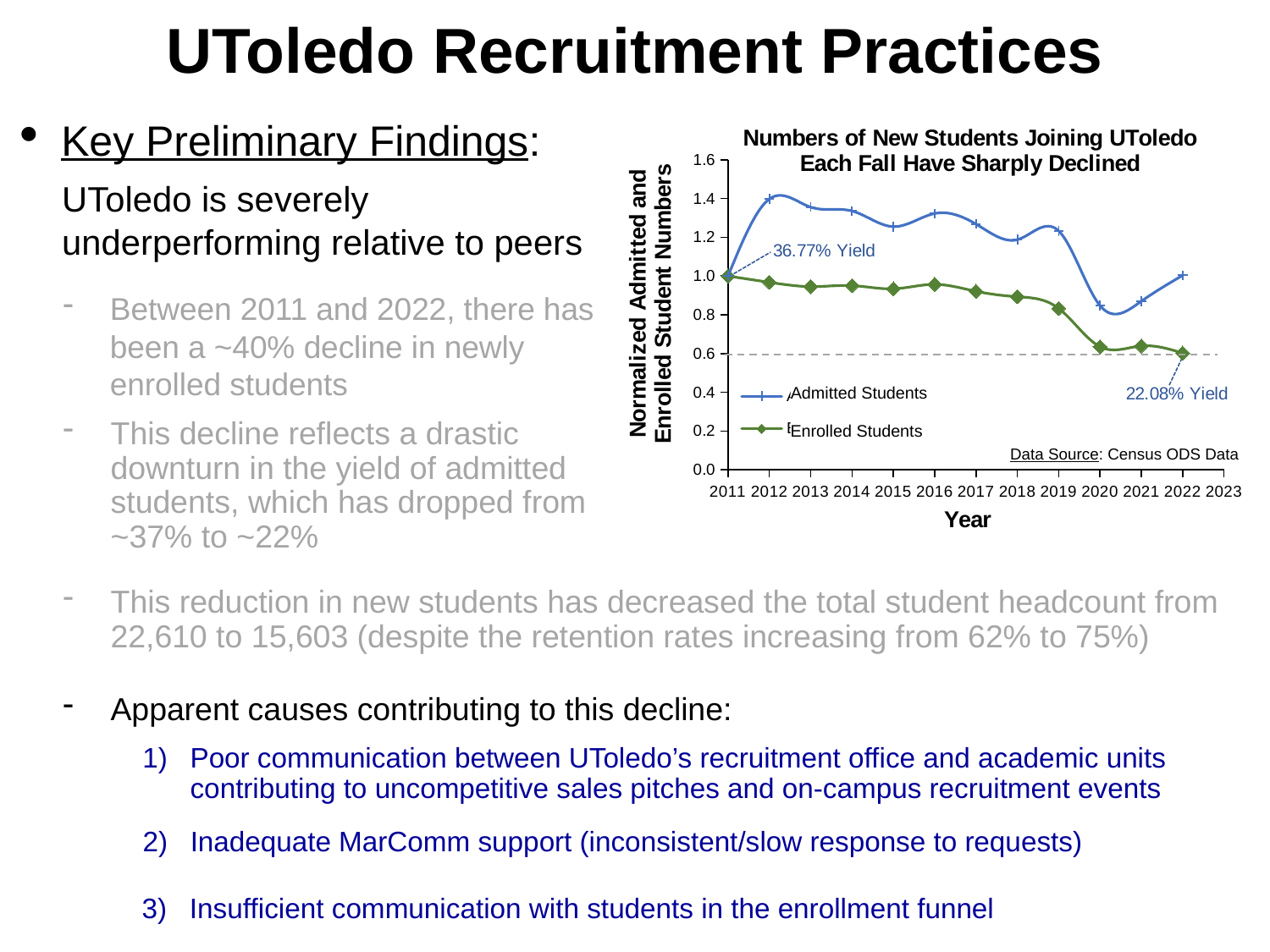
In 2016, which series has the larger value, Admitted Students or Enrolled Students? Admitted Students Is the Enrolled Students value for 2019 greater or less than 0.6? greater What is the title of the chart? Numbers of New Students Joining UToledo Each Fall Have Sharply Declined What yield percentage is annotated at the 2011 point on the chart? 36.77% Yield Is the Admitted Students value for 2012 greater or less than 1.2? greater What yield percentage is annotated at the 2022 point on the chart? 22.08% Yield What data source is cited on the chart? Census ODS Data How many series does the chart's legend list? 2 Is the Enrolled Students value for 2022 greater or less than 0.8? less What kind of chart is shown on the slide? Line chart In which year does the Admitted Students series reach its highest value? 2012 Overall, do the Enrolled Students values rise or fall from 2011 to 2022? Fall